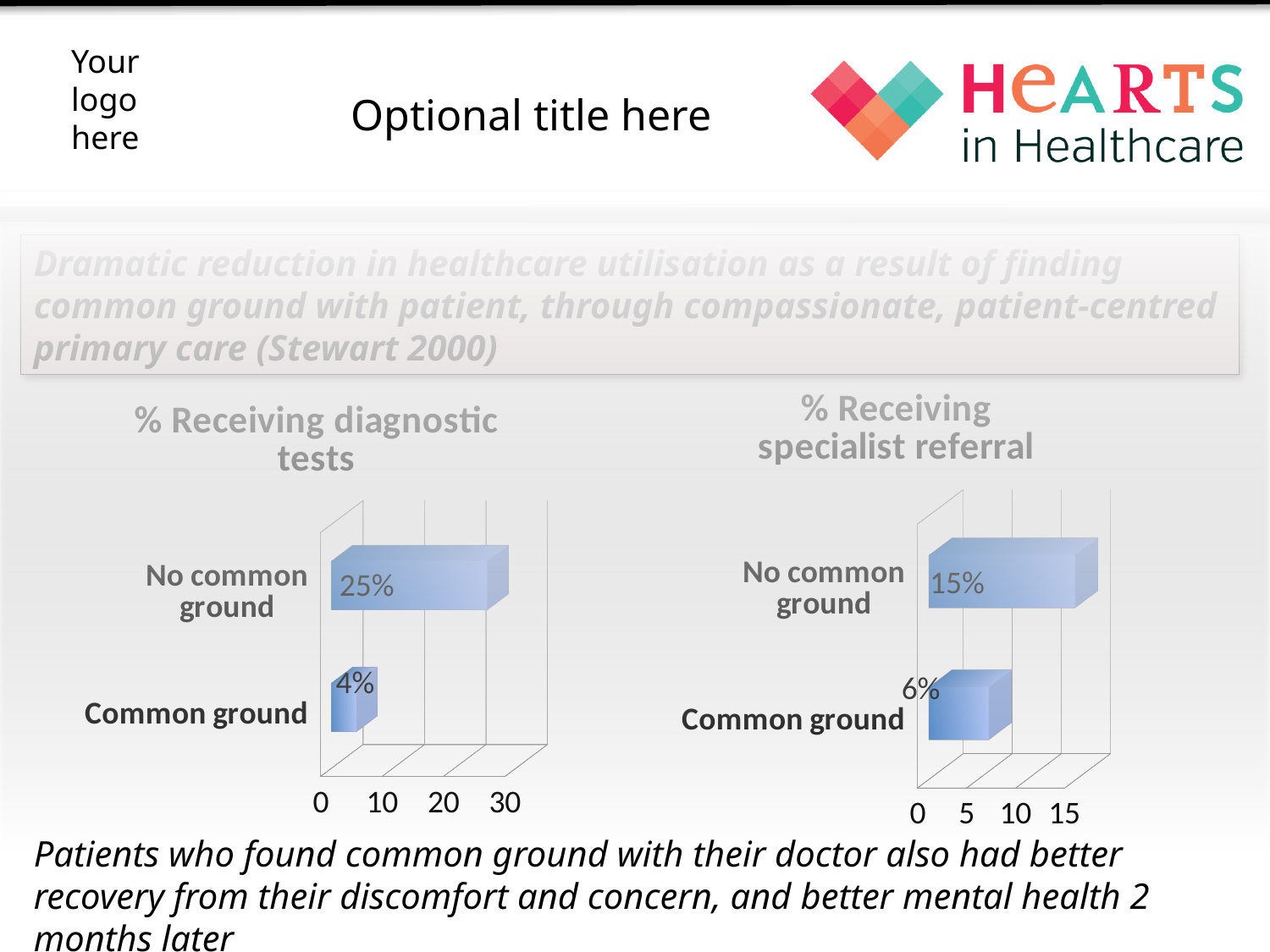
In the '% Receiving specialist referral' chart, what is the value for 'No common ground'? 15% In the '% Receiving specialist referral' chart, which category has the lowest value? Common ground What kind of chart is the '% Receiving diagnostic tests' chart? Bar chart In the '% Receiving diagnostic tests' chart, what is the difference between 'No common ground' and 'Common ground'? 21% In the '% Receiving specialist referral' chart, what is the difference between 'No common ground' and 'Common ground'? 9% In the '% Receiving diagnostic tests' chart, what is the value for 'No common ground'? 25% In the '% Receiving diagnostic tests' chart, which category has the highest value? No common ground In the '% Receiving specialist referral' chart, which is larger: 'No common ground' or 'Common ground'? No common ground In the '% Receiving diagnostic tests' chart, is the value for 'No common ground' greater or less than 20? greater In the '% Receiving specialist referral' chart, what is the value for 'Common ground'? 6% How many categories does the '% Receiving specialist referral' chart show? 2 In the '% Receiving diagnostic tests' chart, what is the value for 'Common ground'? 4%